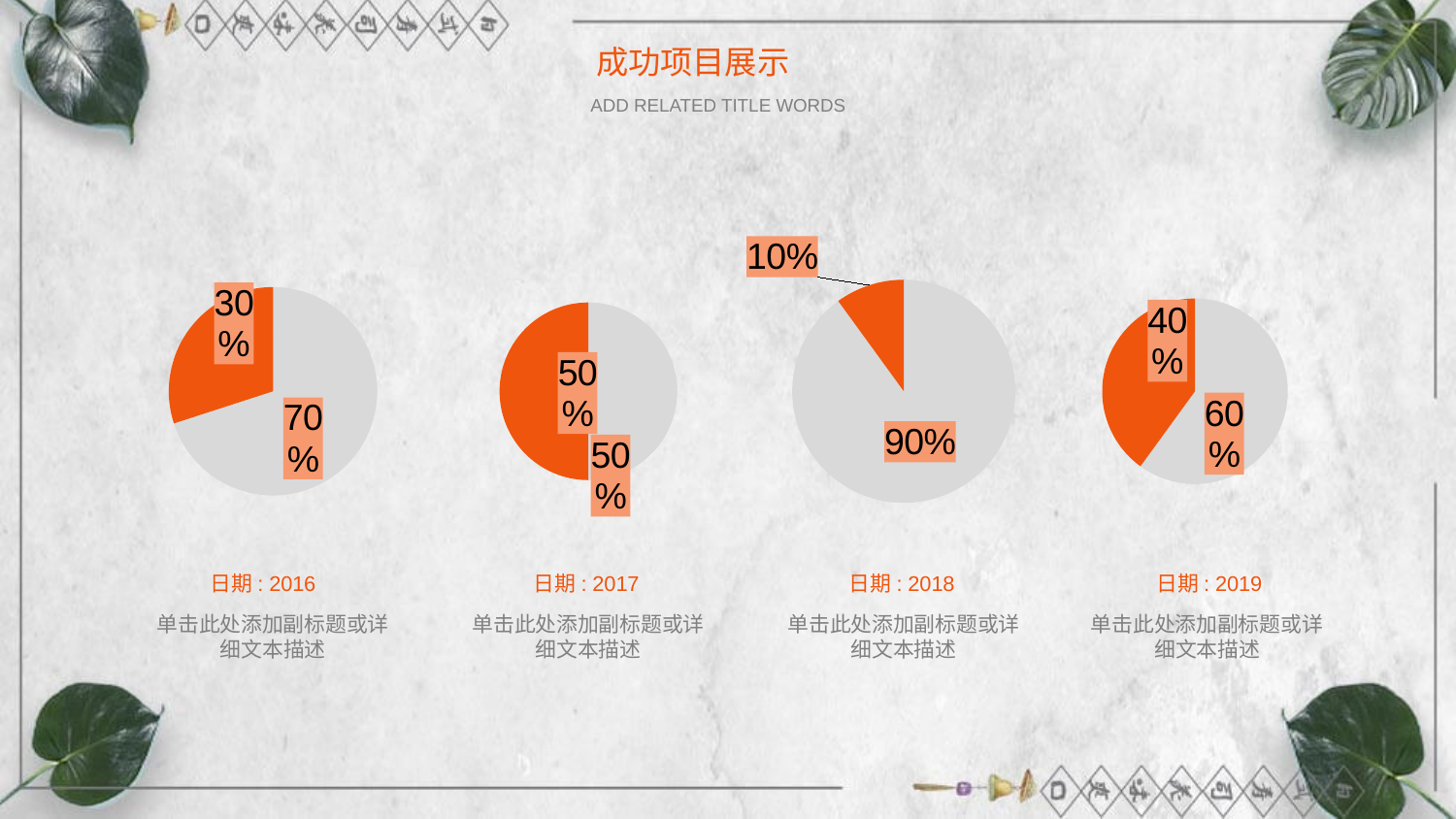
In the pie chart above 日期：2017, what share does the orange slice have? 50% Which pie chart has the largest orange slice? The one above 日期：2017 In the pie chart above 日期：2016, what share does the orange slice have? 30% In the pie chart above 日期：2016, what share does the grey slice have? 70% How many pie charts are on the slide? 4 Which pie chart has the smallest orange slice? The one above 日期：2018 How many slices does each pie chart have? 2 What kind of charts are shown on the slide? Pie charts